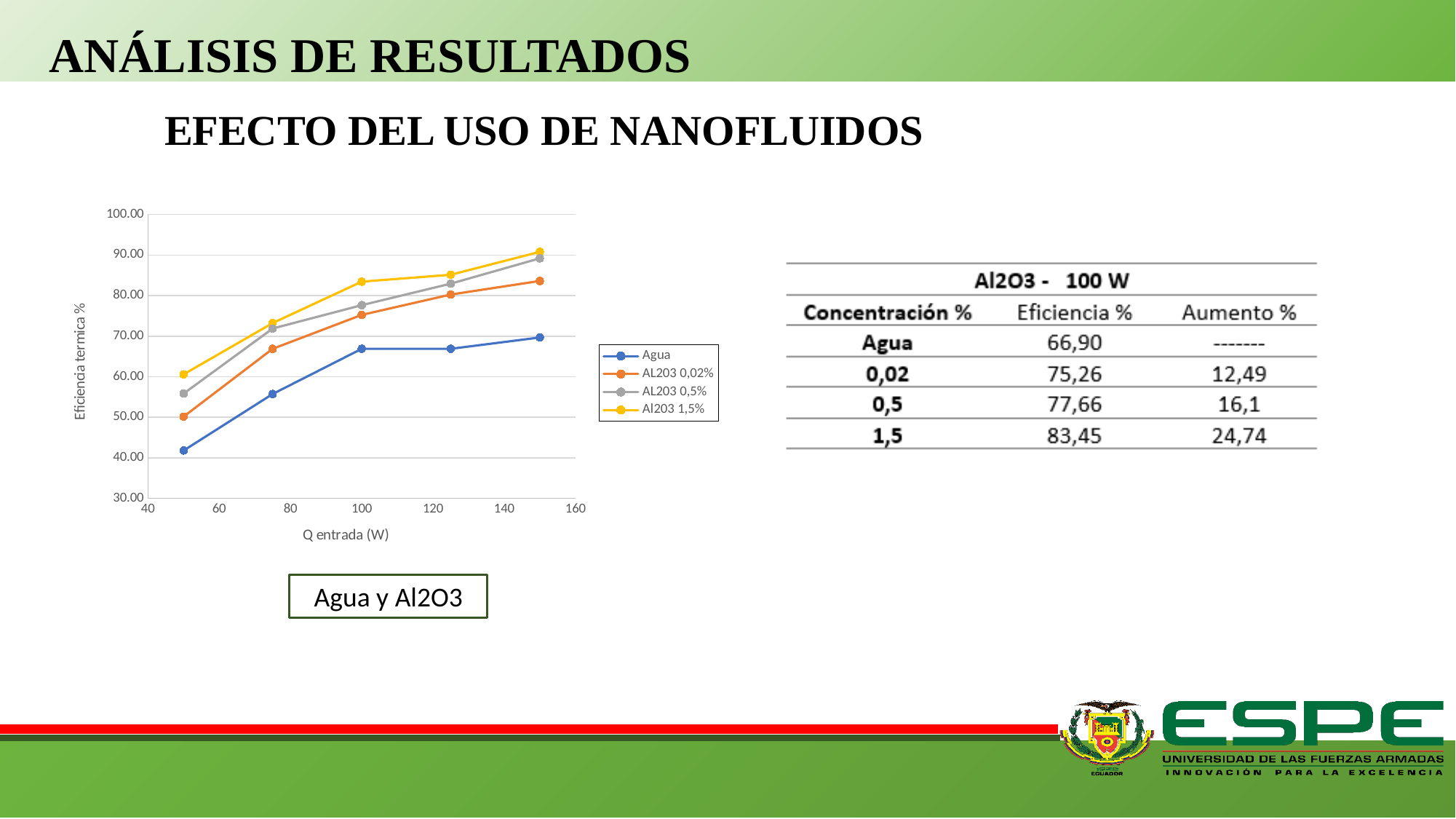
Is the value for Al203 1,5% at 100 W greater or less than 80? greater What is the title of the chart's x axis? Q entrada (W) Is the value for Agua at 75 W greater or less than 60? less What kind of chart is shown on the slide? line chart At 100 W, which is larger: the value for Agua or the value for AL203 0,02%? AL203 0,02% Which series has the lowest values across the chart? Agua Is the value for Agua at 100 W greater or less than 60? greater How many data points are plotted for the Agua series? 5 Do the values of the Al203 1,5% series rise or fall as Q entrada increases? rise How many series does the chart's legend list? 4 Which series has the highest value at 50 W? Al203 1,5%